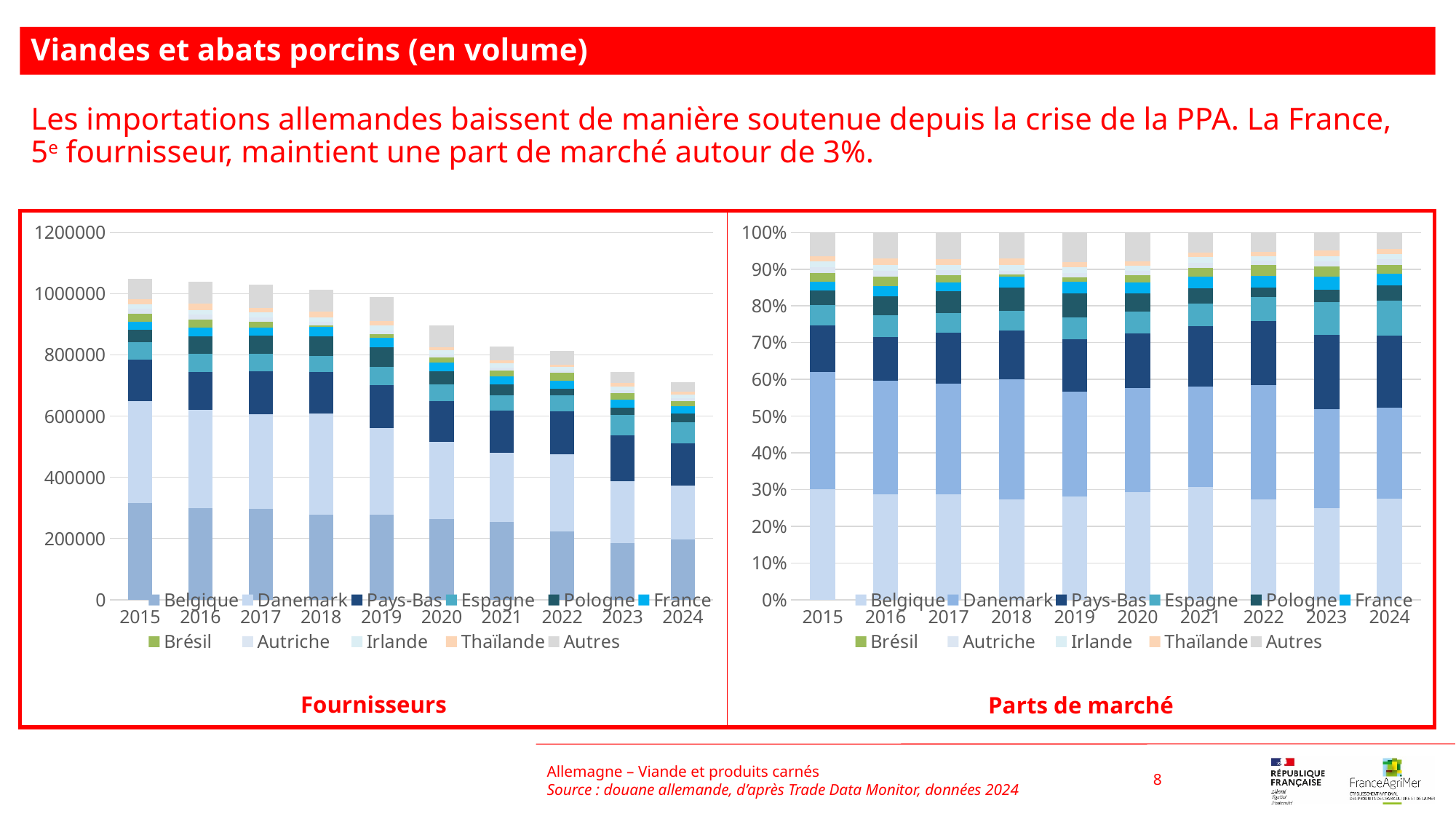
What is the title of the chart on the right? Parts de marché In the 'Fournisseurs' chart, is the total bar for 2015 greater or less than 1000000? greater In the 'Fournisseurs' chart, which year has the lowest total bar? 2024 How many years are shown on the x axis of the 'Fournisseurs' chart? 10 In the 'Fournisseurs' chart, do the total bar heights rise or fall from 2015 to 2024? fall What kind of chart is the 'Fournisseurs' chart on the left? stacked bar chart In the 'Fournisseurs' chart, which year has the highest total bar? 2015 In the 'Fournisseurs' chart, which total bar is larger, 2016 or 2023? 2016 How many series does the legend of the 'Parts de marché' chart list? 11 Which series is listed first in the legend of the 'Fournisseurs' chart? Belgique In the 'Parts de marché' chart, is the Belgique share in 2023 greater or less than 30%? less In the 'Fournisseurs' chart, is the total bar for 2024 greater or less than 800000? less